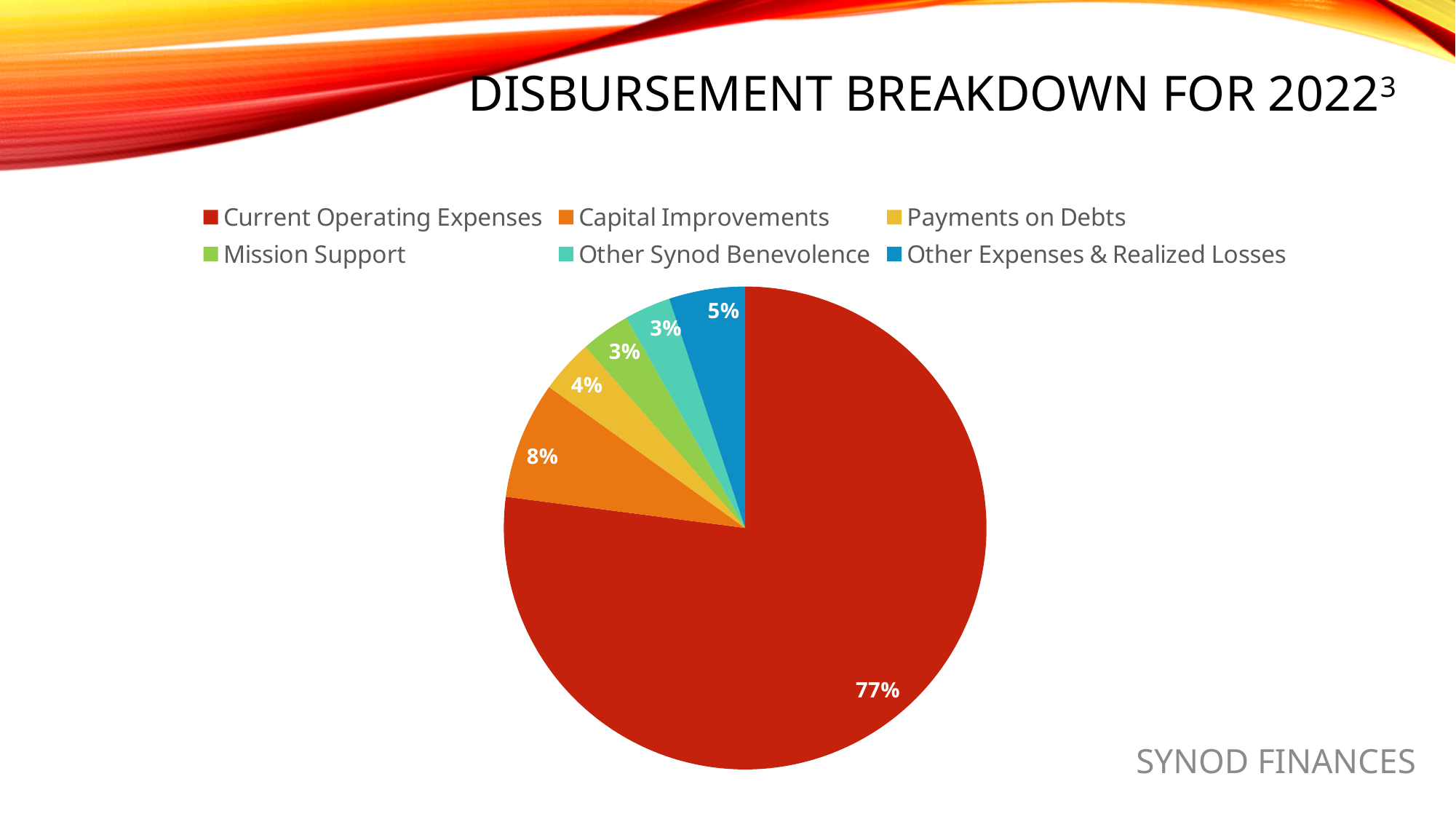
What is the difference in percentage points between Current Operating Expenses and Capital Improvements? 69 What share of disbursements is Mission Support? 3% Which is larger, Capital Improvements or Other Expenses & Realized Losses? Capital Improvements What colour is the Other Expenses & Realized Losses slice? blue How many categories does the pie chart show? 6 What share of disbursements is Capital Improvements? 8% What share of disbursements is Current Operating Expenses? 77% What is the title of the chart slide? Disbursement Breakdown for 2022 What kind of chart is shown on the slide? pie chart Which category has the largest share of disbursements? Current Operating Expenses